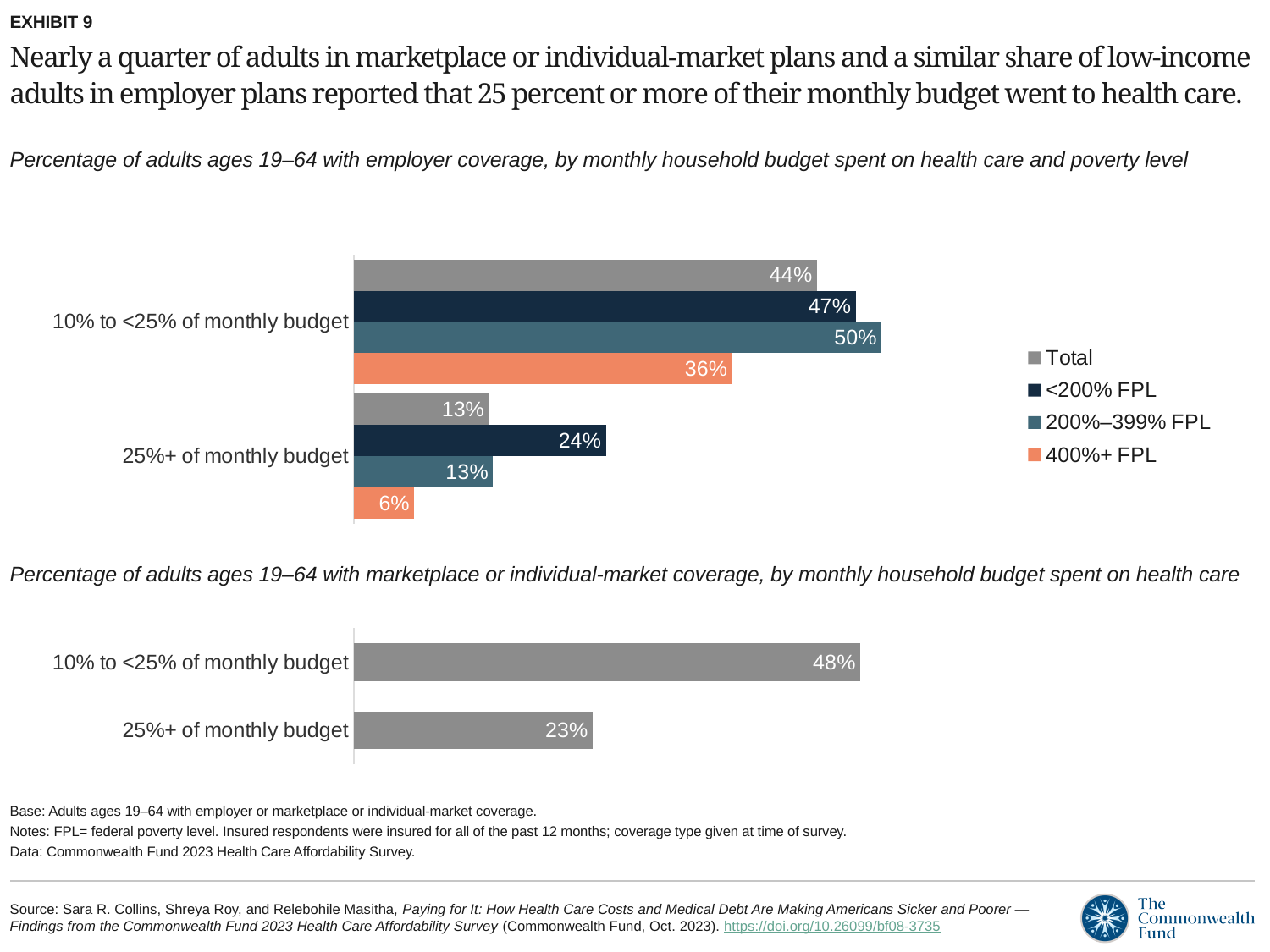
In the employer coverage chart, which series has the lowest value in the 25%+ of monthly budget category? 400%+ FPL How many series does the legend of the employer coverage chart list? 4 What type of chart is the marketplace or individual-market coverage chart? Bar chart In the employer coverage chart, what is the value for <200% FPL in the 25%+ of monthly budget category? 24% In the marketplace or individual-market coverage chart, what is the value for 25%+ of monthly budget? 23% How many categories are shown in the marketplace or individual-market coverage chart? 2 In the employer coverage chart, which is larger for 10% to <25% of monthly budget: <200% FPL or 400%+ FPL? <200% FPL In the employer coverage chart, which series has the highest value in the 10% to <25% of monthly budget category? 200%–399% FPL In the employer coverage chart, what is the value for 200%–399% FPL in the 10% to <25% of monthly budget category? 50% In the employer coverage chart, what is the difference between the <200% FPL and 400%+ FPL values for 25%+ of monthly budget? 18 percentage points In the employer coverage chart, what is the Total value for 10% to <25% of monthly budget? 44% In the marketplace or individual-market coverage chart, what is the difference between the 10% to <25% and 25%+ of monthly budget values? 25 percentage points